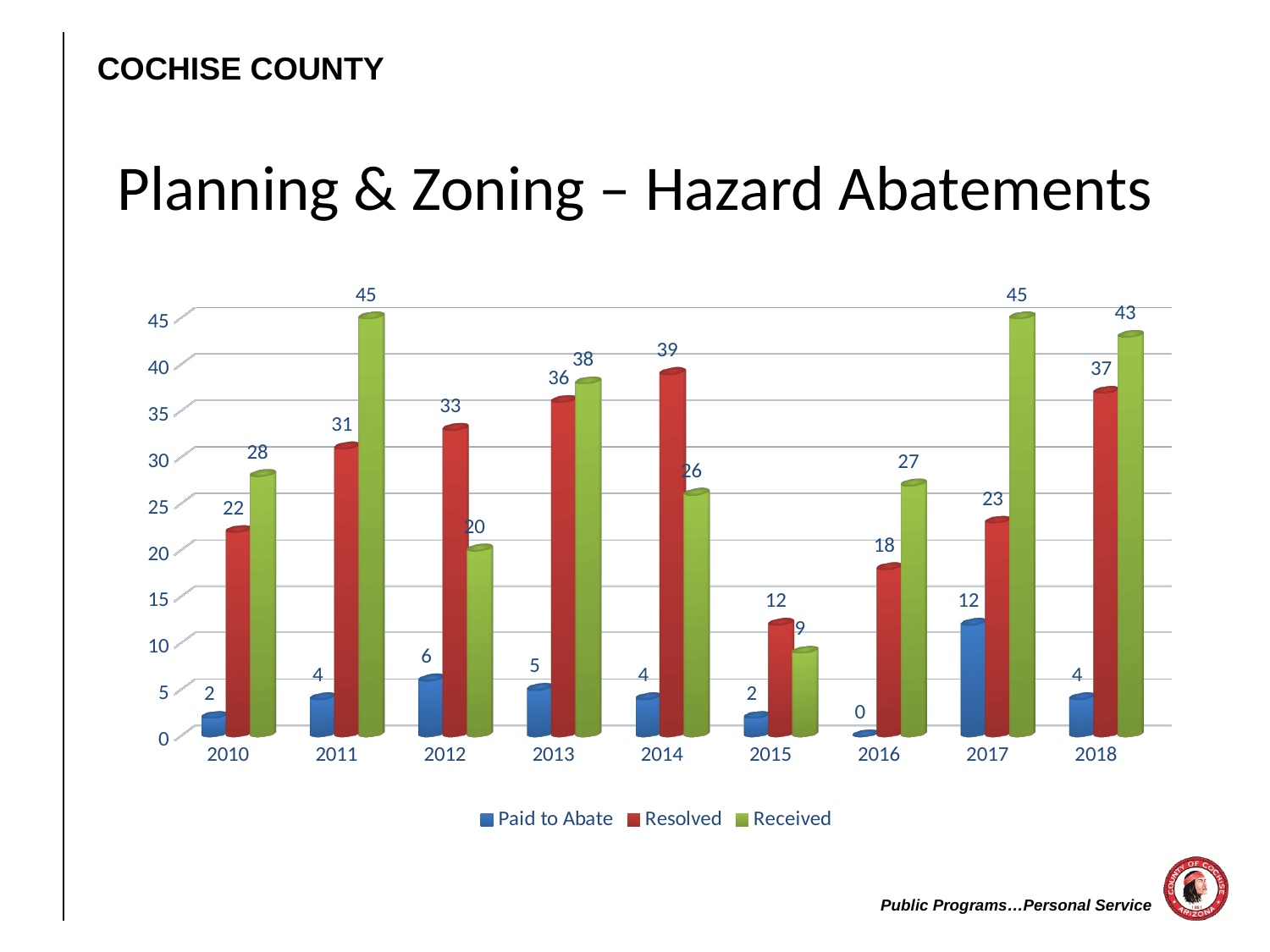
Which series is shown in green in the legend? Received What is the Resolved value for 2014? 39 Which year has the highest Resolved value? 2014 How many series does the legend list? 3 What kind of chart is shown on the slide? Bar chart What is the Paid to Abate value for 2017? 12 Which year has the lowest Paid to Abate value? 2016 What is the difference between the Received and Resolved values in 2018? 6 Which is larger in 2012, the Resolved value or the Received value? Resolved How many years are shown on the x axis? 9 Which year has the lowest Received value? 2015 What is the Received value for 2012? 20